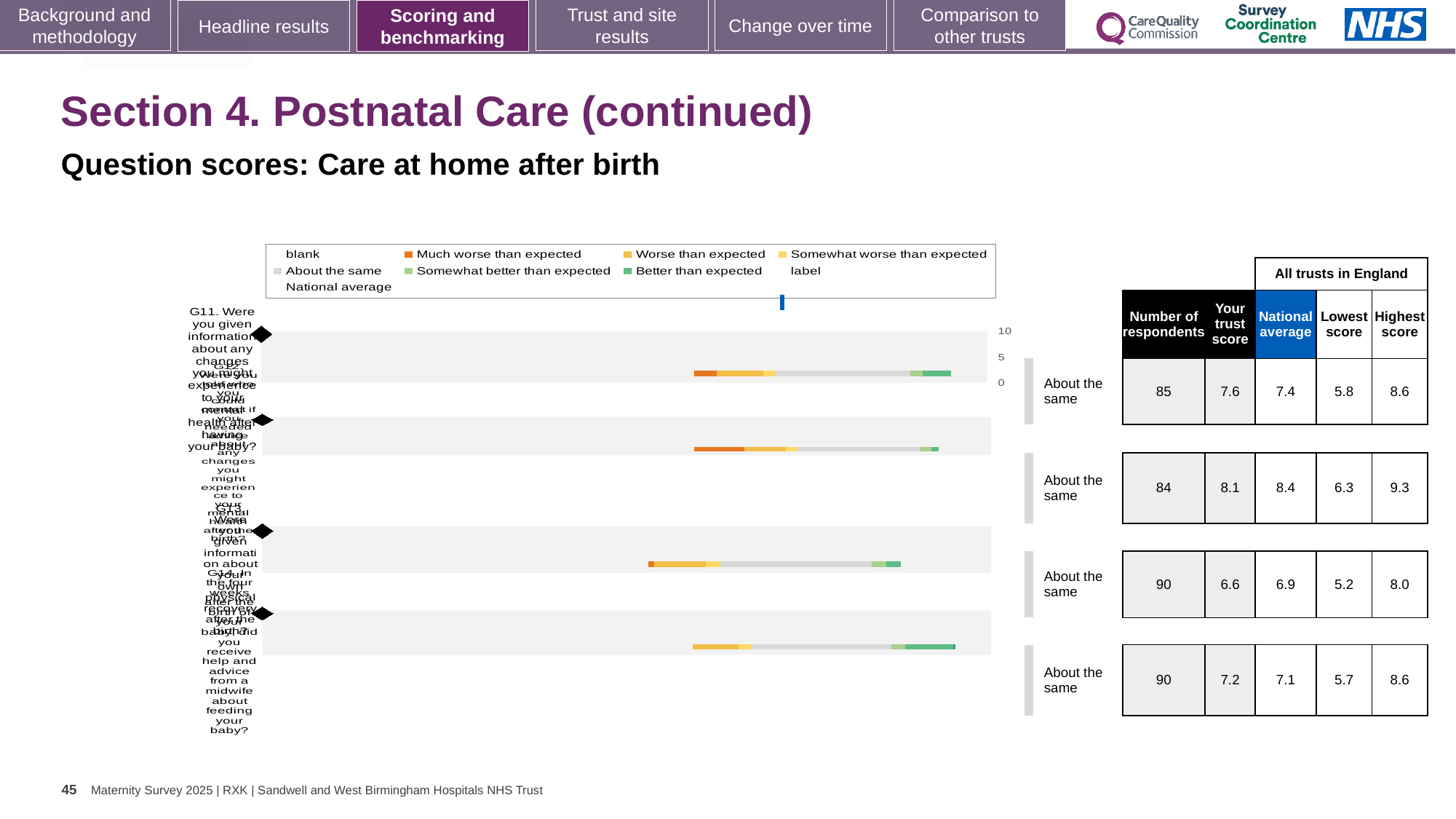
In the table, what is the highest score for the third row? 8.0 In the second row of the table, which is larger: the trust score or the national average? National average (8.4) In the table, what is the 'Your trust score' value for the second row? 8.1 How many bars (questions) are plotted in the chart? 4 Which row of the table has the highest 'Your trust score'? the second row (8.1) In the table, what is the national average for the fourth row? 7.1 What kind of chart is shown on the slide? bar chart Which row of the table has the lowest 'Your trust score'? the third row (6.6) What colour represents 'Much worse than expected' in the chart legend? orange In the table, what is the number of respondents for the first row (G11)? 85 In the first row of the table, what is the difference between the highest score and the lowest score? 2.8 What benchmark category is shown next to each of the four bars? About the same